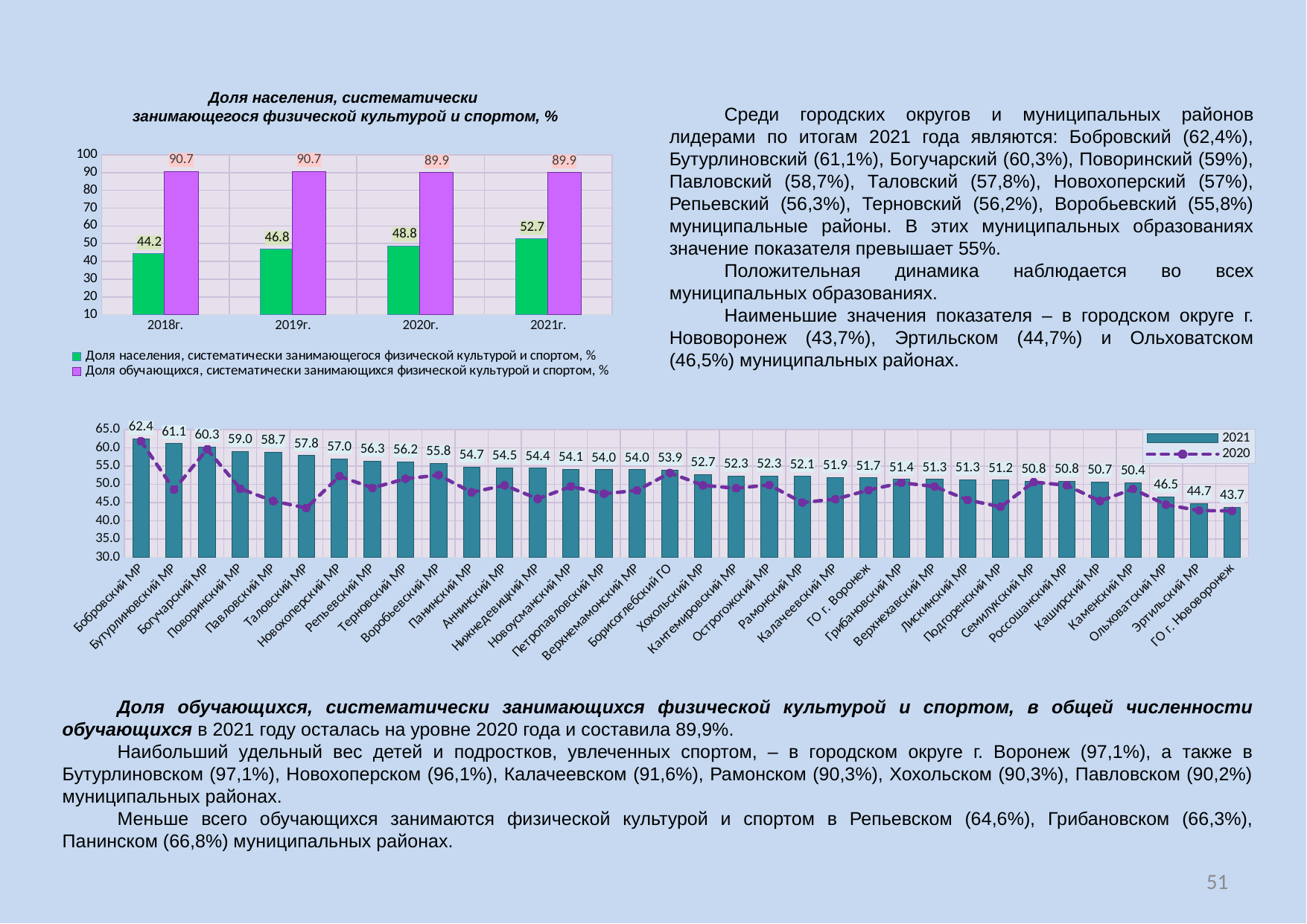
In the top-left chart, what is the value of 'Доля обучающихся, систематически занимающихся физической культурой и спортом, %' for 2018г.? 90.7 In the top-left chart, what is the difference between the two series' values for 2020г.? 41.1 In the bottom chart, is the 2020 value for Таловский МР greater or less than 45.0? less In the top-left chart, does the green series ('Доля населения...') rise or fall from 2018г. to 2021г.? rise In the bottom chart, what is the 2021 value for Павловский МР? 58.7 In the bottom chart, which category has the highest 2021 value? Бобровский МР What kind of chart is the top-left chart? bar chart In the top-left chart titled 'Доля населения, систематически занимающегося физической культурой и спортом, %', what is the value of 'Доля населения, систематически занимающегося физической культурой и спортом, %' for 2021г.? 52.7 In the bottom chart, what is the difference between the 2021 values for Бобровский МР and Эртильский МР? 17.7 In the top-left chart, how many series does the legend list? 2 In the bottom chart, how many categories are shown on the x axis? 34 In the bottom chart, which category has the lowest 2021 value? ГО г. Нововоронеж